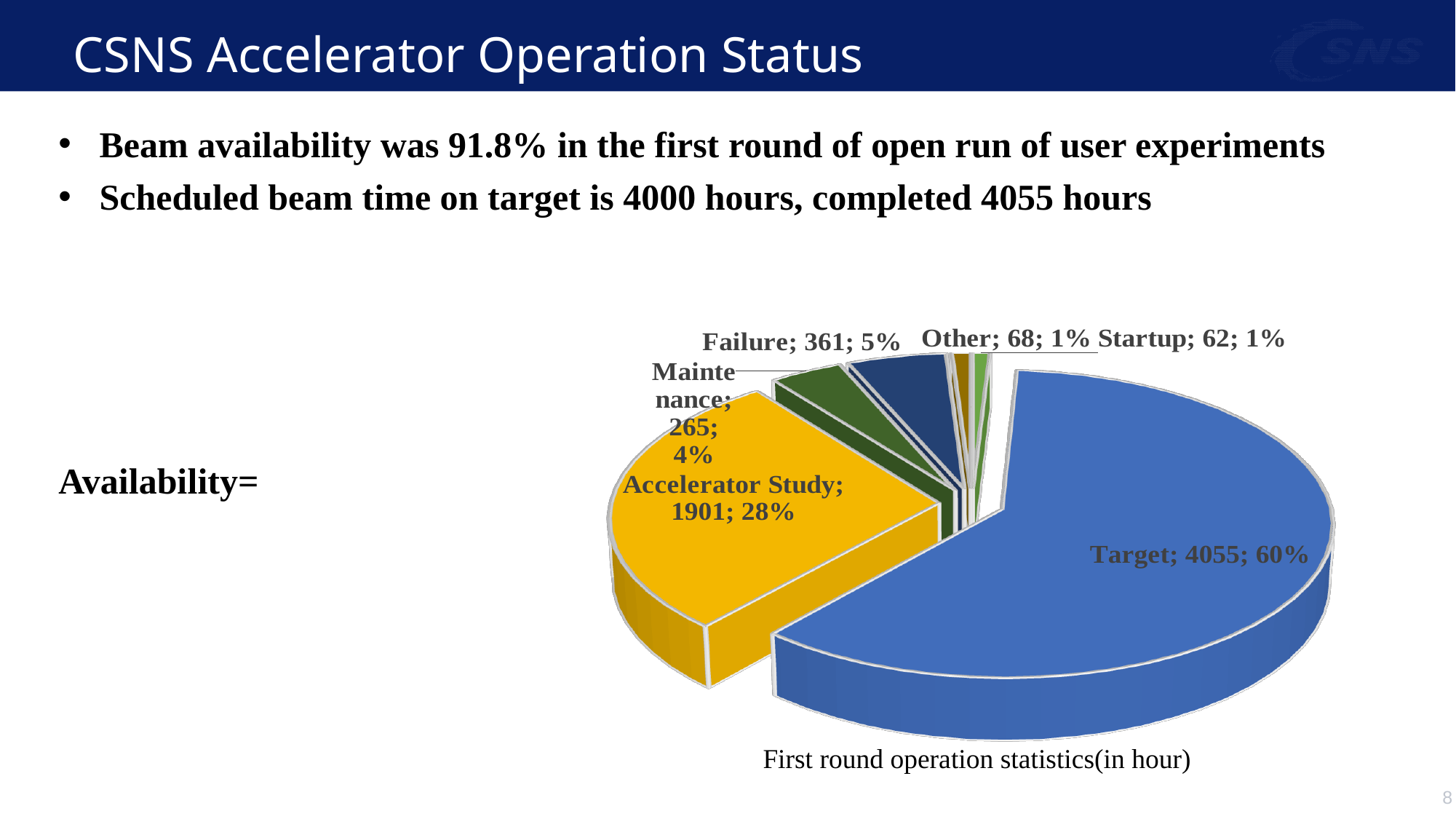
What is the difference in hours between Failure and Maintenance? 96 How many hours are shown for Target in the pie chart? 4055 How many categories are shown in the pie chart? 6 Which category has the largest slice in the pie chart? Target How many hours are shown for Accelerator Study in the pie chart? 1901 Which has more hours, Failure or Maintenance? Failure What share of the pie does Accelerator Study represent? 28% What share of the pie does Target represent? 60% How many hours are shown for Maintenance in the pie chart? 265 Which category has the smallest slice in the pie chart? Startup How many hours are shown for Failure in the pie chart? 361 What kind of chart is shown on the slide? Pie chart